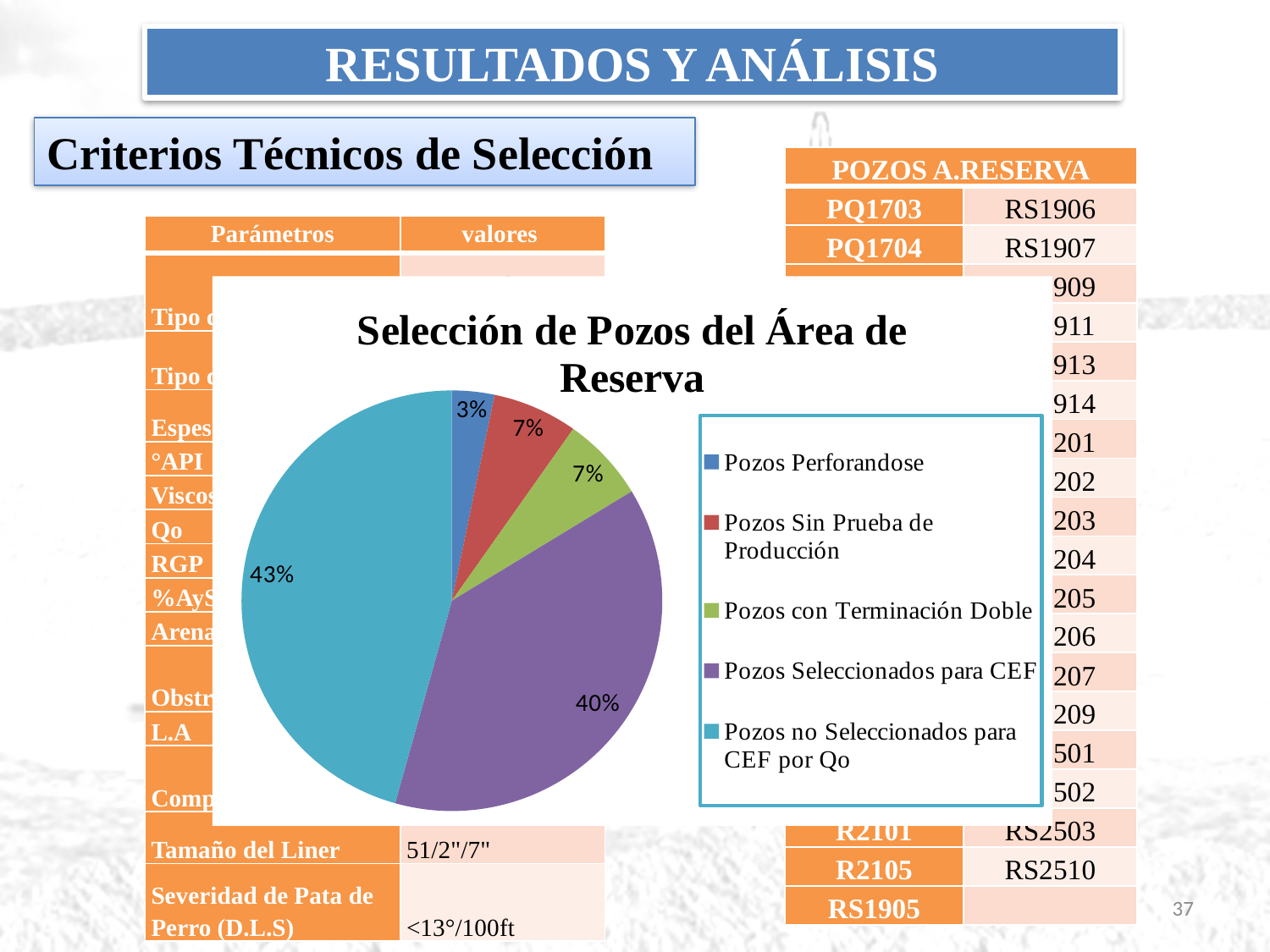
How many entries does the legend of the pie chart list? 5 What share of the pie is Pozos Seleccionados para CEF? 40% What is the difference in percentage points between Pozos no Seleccionados para CEF por Qo and Pozos Seleccionados para CEF? 3% What share of the pie is Pozos Perforandose? 3% Which colour represents Pozos Sin Prueba de Producción in the pie chart? red Which category has the largest slice of the pie? Pozos no Seleccionados para CEF por Qo What is the title of the pie chart? Selección de Pozos del Área de Reserva What share of the pie is Pozos con Terminación Doble? 7% Which category has the smallest slice of the pie? Pozos Perforandose How many slices does the pie chart have? 5 What kind of chart is shown on the slide? pie chart